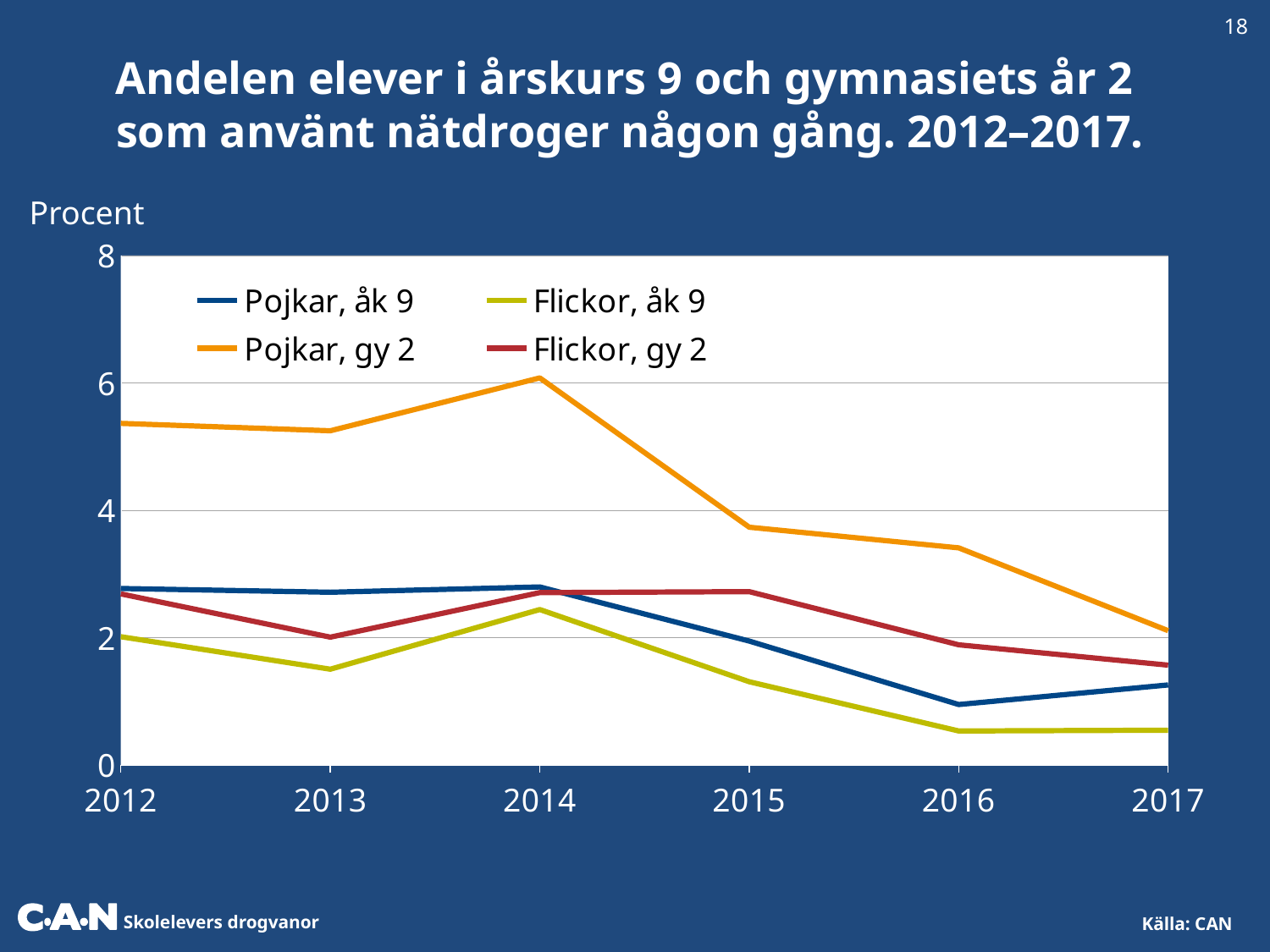
Which series has the highest value in 2014? Pojkar, gy 2 How many years are shown on the x axis? 6 Is the value for Flickor, åk 9 in 2016 greater or less than 2? less Is the value for Pojkar, gy 2 in 2012 greater or less than 4? greater What is the label on the y axis? Procent Is the value for Pojkar, gy 2 in 2015 greater or less than 4? less How many series does the legend list? 4 In 2013, which is larger: Flickor, gy 2 or Flickor, åk 9? Flickor, gy 2 In 2017, which is larger: Pojkar, åk 9 or Flickor, åk 9? Pojkar, åk 9 Which series has the lowest value in 2016? Flickor, åk 9 Does the Pojkar, gy 2 line rise or fall from 2014 to 2017? Falls What kind of chart is shown on the slide? Line chart